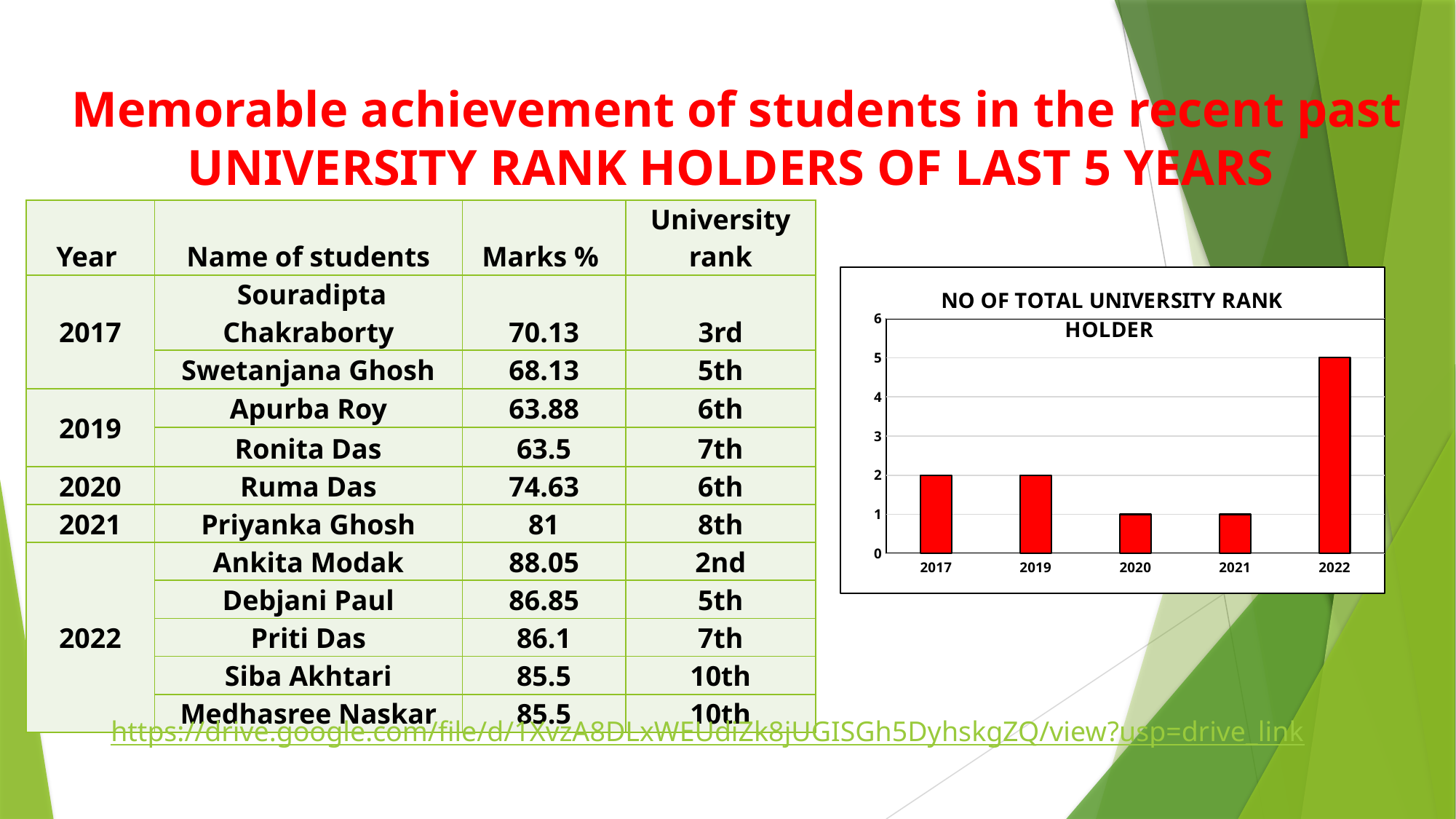
What is the difference between the number of rank holders in 2022 and 2017 in the chart? 3 Which has more university rank holders in the chart, 2019 or 2021? 2019 What colour are the bars in the chart? red What is the number of university rank holders for 2022 in the chart? 5 What is the number of university rank holders for 2020 in the chart? 1 Is the value for 2022 in the chart greater or less than 4? greater What is the number of university rank holders for 2017 in the chart? 2 What kind of chart is shown on the slide? bar chart Is the value for 2021 in the chart greater or less than 2? less How many years are shown on the x axis of the chart? 5 Which year has the highest number of university rank holders in the chart? 2022 What is the title of the chart on the slide? NO OF TOTAL UNIVERSITY RANK HOLDER